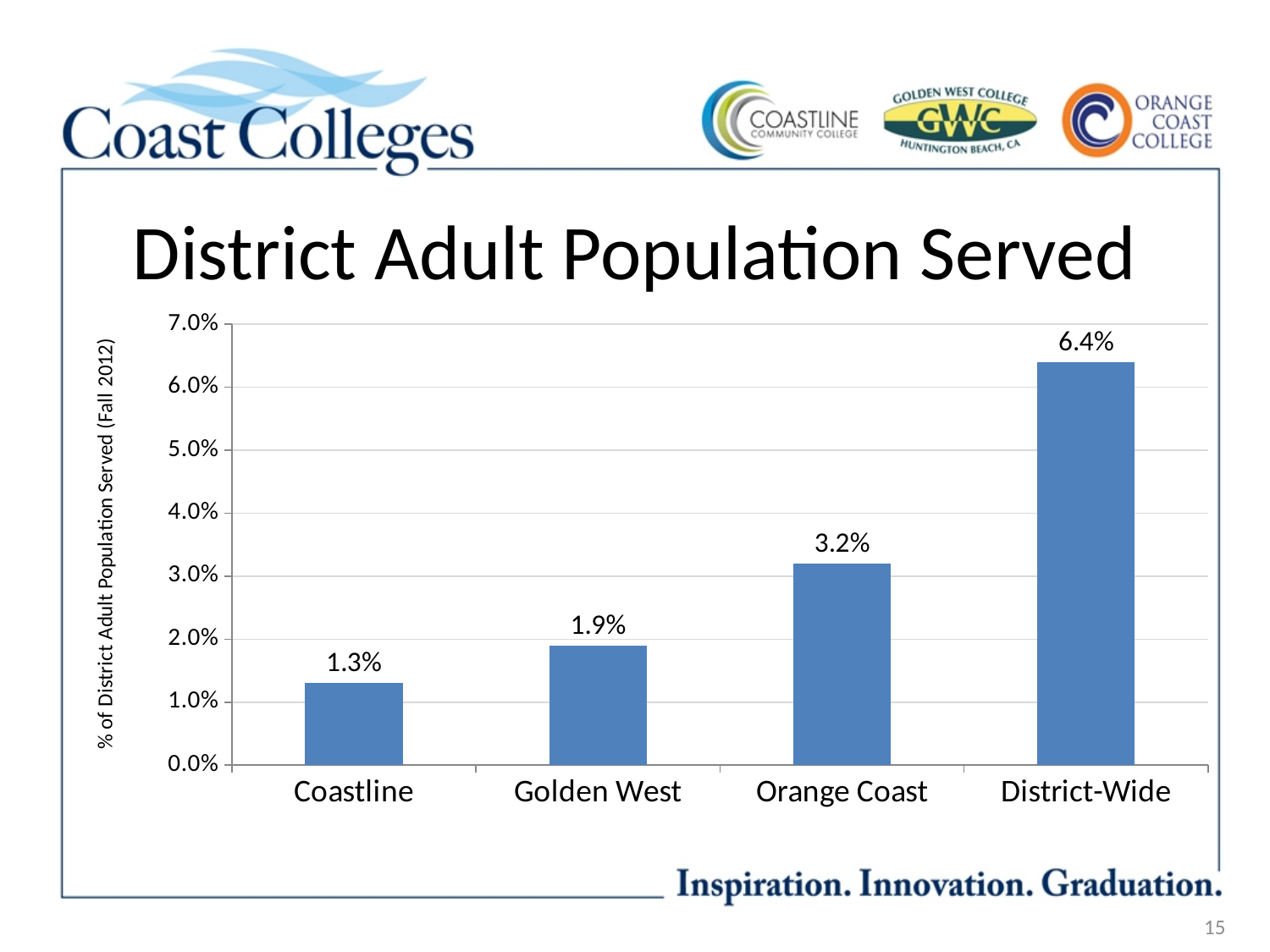
What kind of chart is shown on the slide? Bar chart Which category has the highest value in the chart? District-Wide What is the difference between the Orange Coast and Golden West percentages? 1.3% How many categories are shown on the x axis of the chart? 4 Is the value for Orange Coast greater or less than 3.0%? greater Which college has the lowest percentage of district adult population served? Coastline Which is larger, the value for Golden West or the value for Coastline? Golden West What is the label of the vertical axis of the chart? % of District Adult Population Served (Fall 2012) What percentage of the district adult population is served by Golden West? 1.9% What percentage of the district adult population is served by Coastline? 1.3% What percentage of the district adult population is served by Orange Coast? 3.2% What is the District-Wide percentage of adult population served? 6.4%